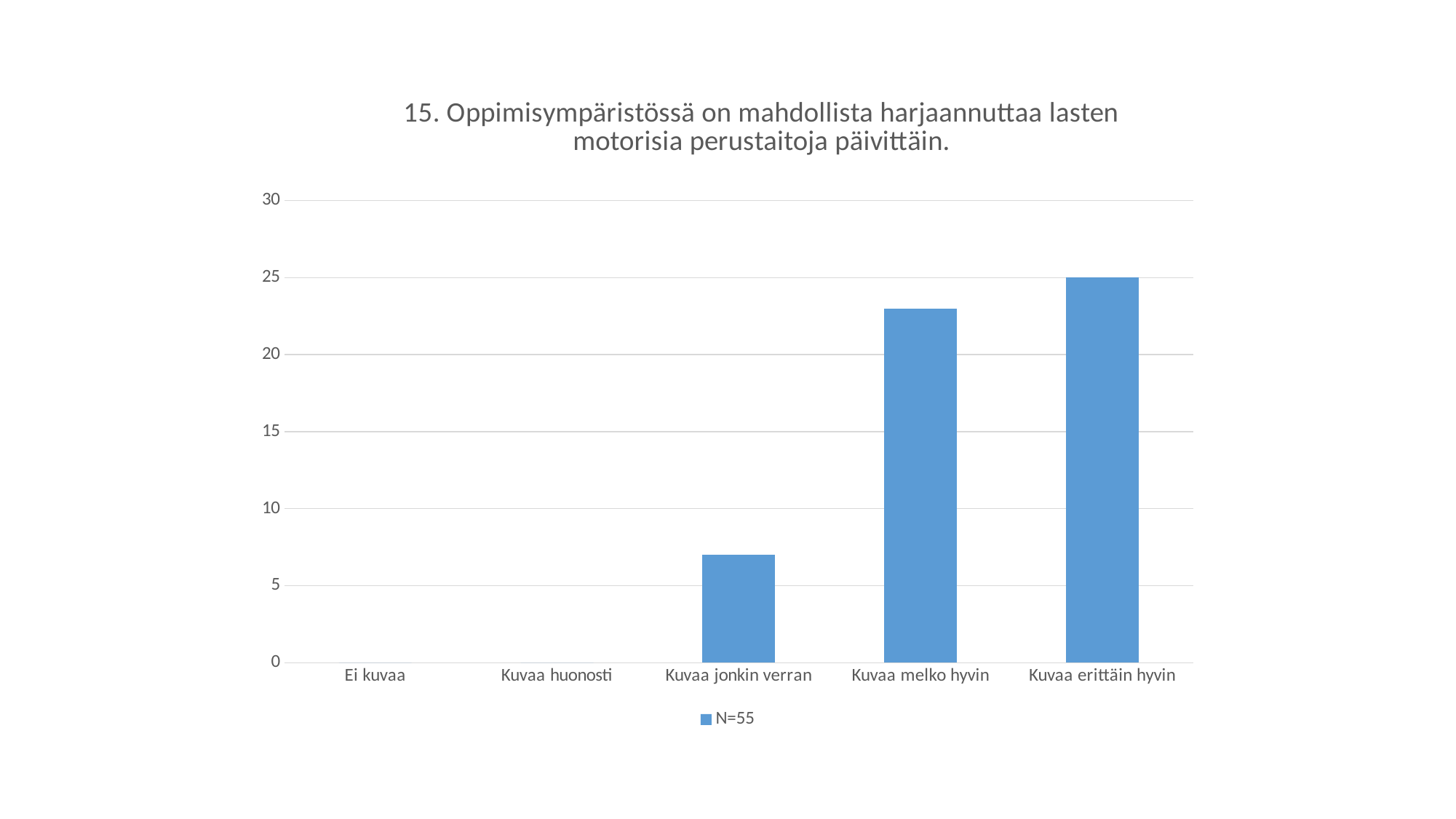
How many series does the legend list? 1 Is the value for Kuvaa jonkin verran greater or less than 10? less How many categories are shown on the x axis of the chart? 5 Do the values rise or fall moving from left to right along the x axis? rise What is the value for Kuvaa erittäin hyvin? 25 Is the value for Kuvaa jonkin verran greater or less than 5? greater Which is larger, the value for Kuvaa melko hyvin or the value for Kuvaa jonkin verran? Kuvaa melko hyvin What kind of chart is shown on the slide? bar chart What is the legend entry shown below the chart? N=55 Which category has the highest value? Kuvaa erittäin hyvin What is the title of the chart? 15. Oppimisympäristössä on mahdollista harjaannuttaa lasten motorisia perustaitoja päivittäin. Is the value for Kuvaa melko hyvin greater or less than 20? greater